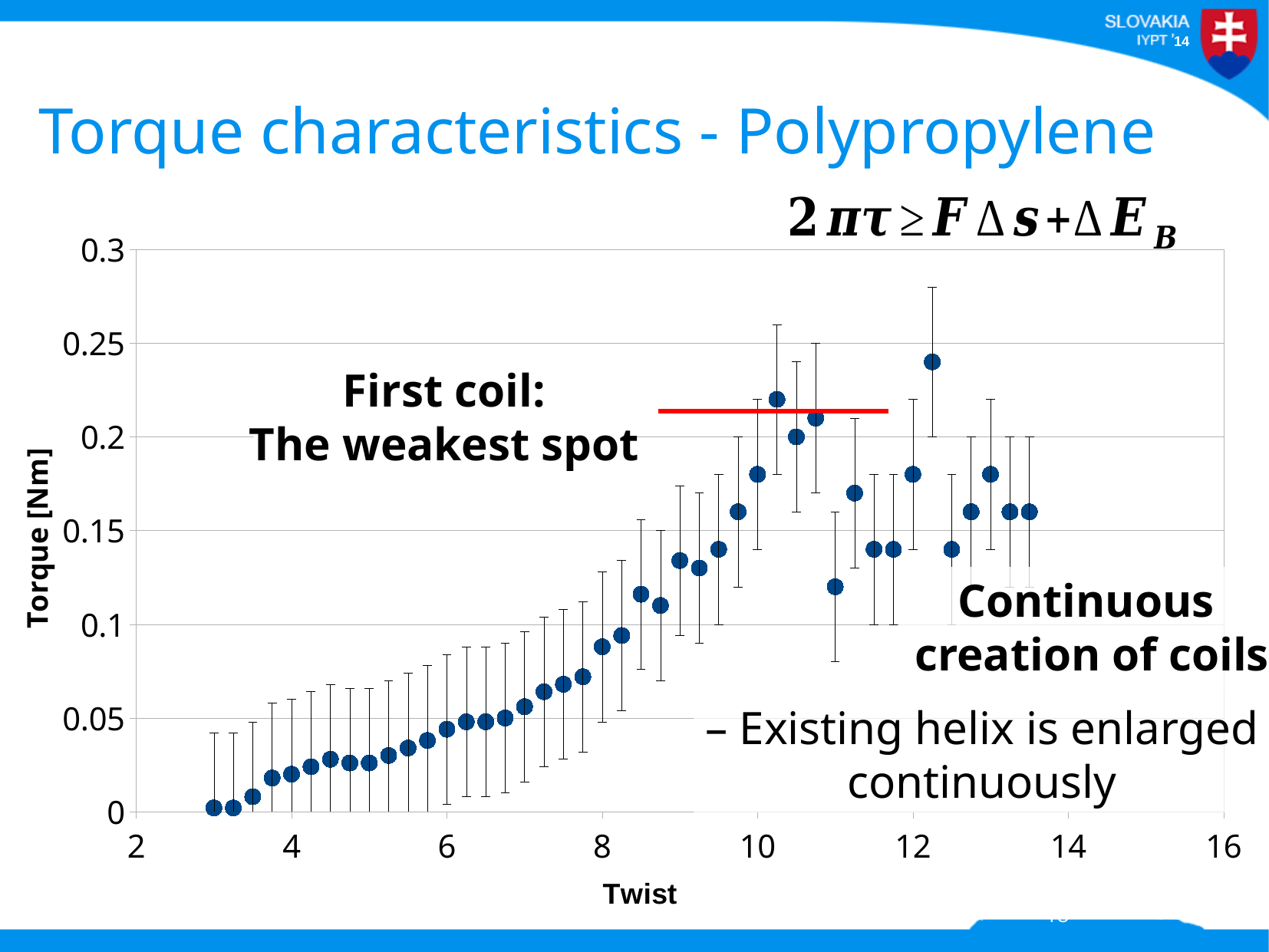
Is the torque value at a twist of 10.25 greater or less than 0.2 Nm? greater Is the torque value at a twist of 4 greater or less than 0.05 Nm? less What is the label of the vertical axis of the chart? Torque [Nm] Which has the larger torque value: the point at twist 4 or the point at twist 10.25? twist 10.25 What is the label of the horizontal axis of the chart? Twist What kind of chart is shown on the slide? scatter plot Is the torque value at a twist of 11 greater or less than 0.15 Nm? less Does the torque generally rise or fall as twist increases from 3 to 10? rise